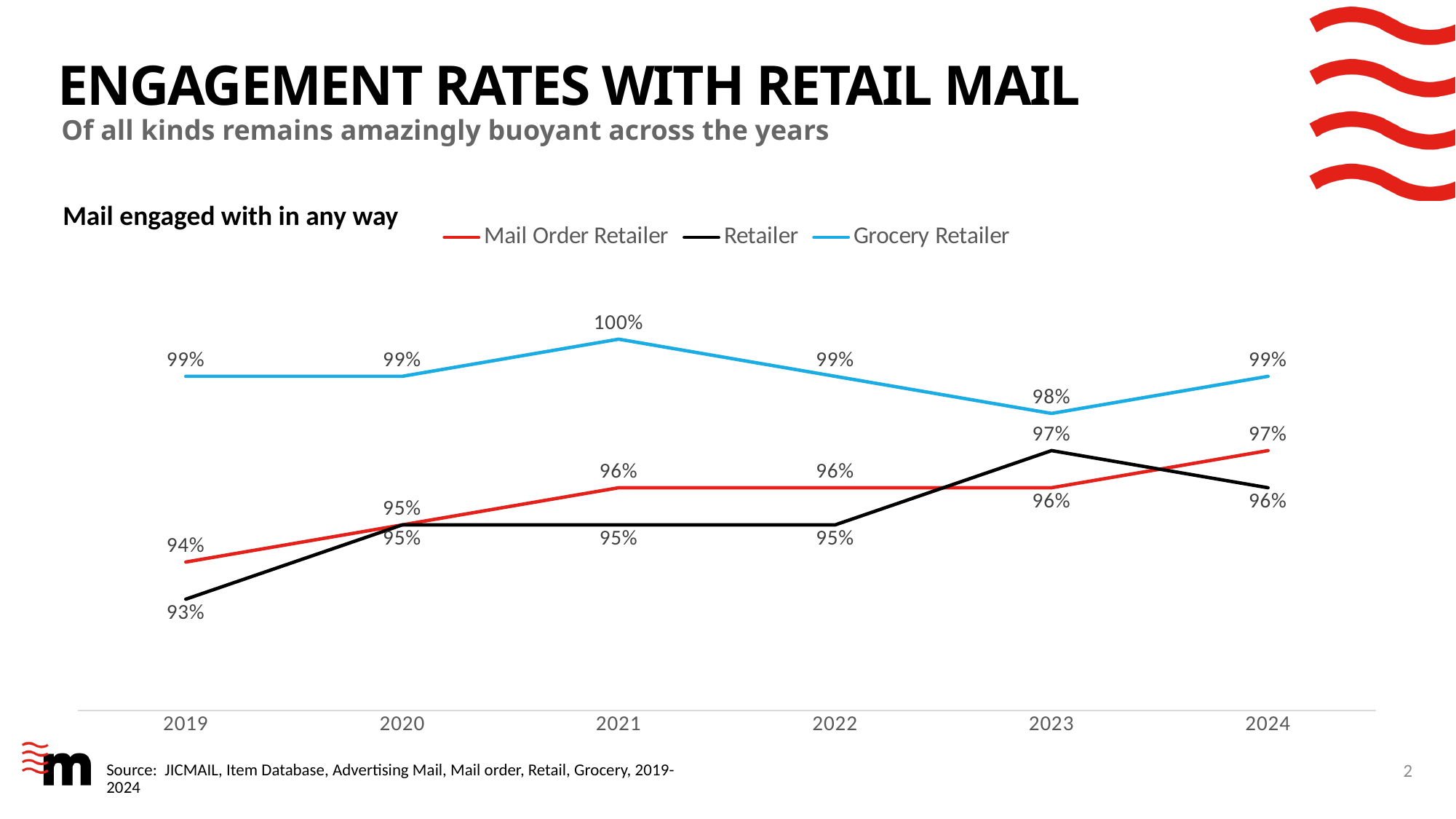
Which series has the higher value in 2024, Mail Order Retailer or Retailer? Mail Order Retailer What is the Retailer engagement rate in 2019? 93% In which year is the Grocery Retailer engagement rate lowest? 2023 Does the Mail Order Retailer engagement rate rise or fall from 2019 to 2024? Rise What is the Retailer engagement rate in 2023? 97% What is the Grocery Retailer engagement rate in 2021? 100% How many series does the legend list? 3 How many years are shown on the x axis? 6 What is the Mail Order Retailer engagement rate in 2019? 94% What is the difference between the Grocery Retailer and Retailer engagement rates in 2019? 6 percentage points In which year is the Mail Order Retailer engagement rate highest? 2024 What kind of chart is shown on the slide? Line chart